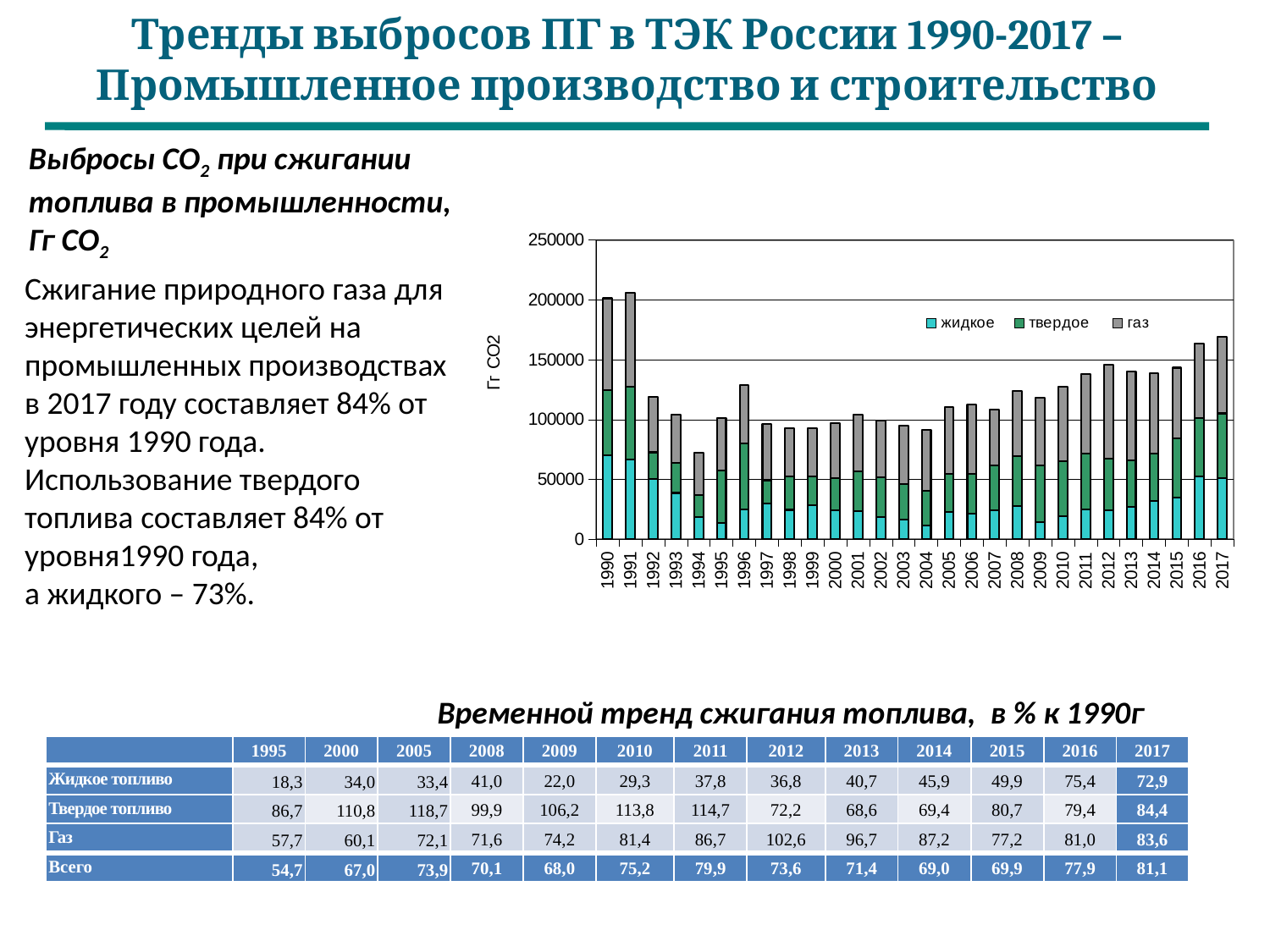
Is the total bar for 1994 greater or less than 100000? less Is the total bar for 2004 greater or less than 100000? less Which year has the lowest total bar in the chart? 1994 Is the total bar for 1996 greater or less than 100000? greater What is the label on the vertical axis of the chart? Гг CO2 How many years are shown along the x axis of the chart? 28 Which series are listed in the chart legend? жидкое, твердое, газ How many series does the chart legend list? 3 Which year has the larger total bar, 1990 or 2017? 1990 Do the total bars rise or fall from 1990 to 1994? fall What kind of chart is shown on the slide? stacked bar chart